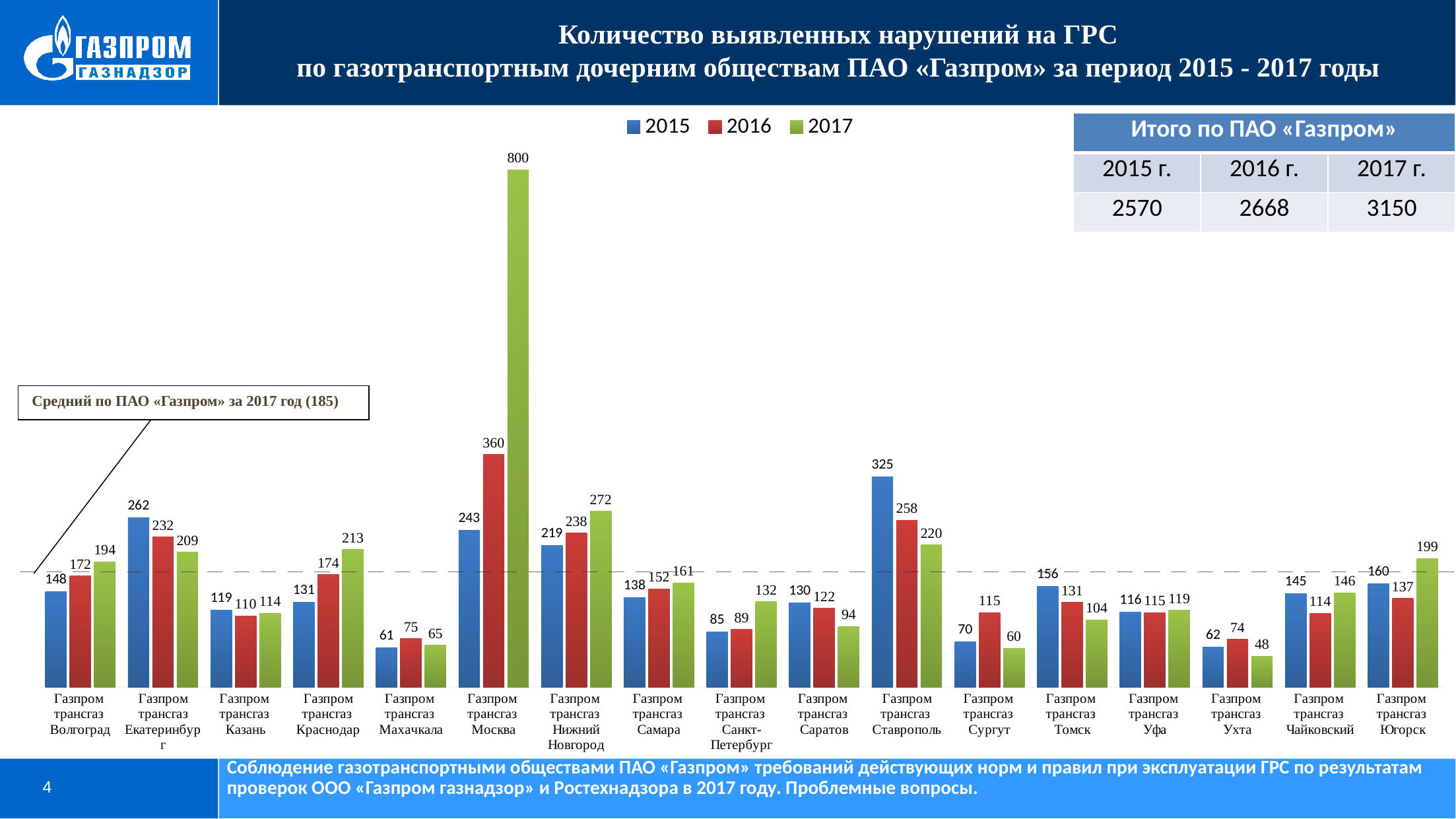
What is the 2015 value for Газпром трансгаз Ставрополь? 325 What is the difference between the 2017 and 2015 values for Газпром трансгаз Нижний Новгород? 53 What type of chart is shown on the slide? bar chart Which company has the highest 2017 value? Газпром трансгаз Москва What is the 2016 value for Газпром трансгаз Краснодар? 174 Which is larger for Газпром трансгаз Екатеринбург: the 2015 value or the 2017 value? 2015 What is the 2017 value for Газпром трансгаз Москва? 800 How many subsidiary companies (categories) are shown on the x axis of the chart? 17 What value does the dashed line labelled 'Средний по ПАО «Газпром» за 2017 год' represent? 185 Do the values for Газпром трансгаз Волгоград rise or fall from 2015 to 2017? rise Which company has the lowest 2017 value? Газпром трансгаз Ухта How many series does the chart legend list? 3